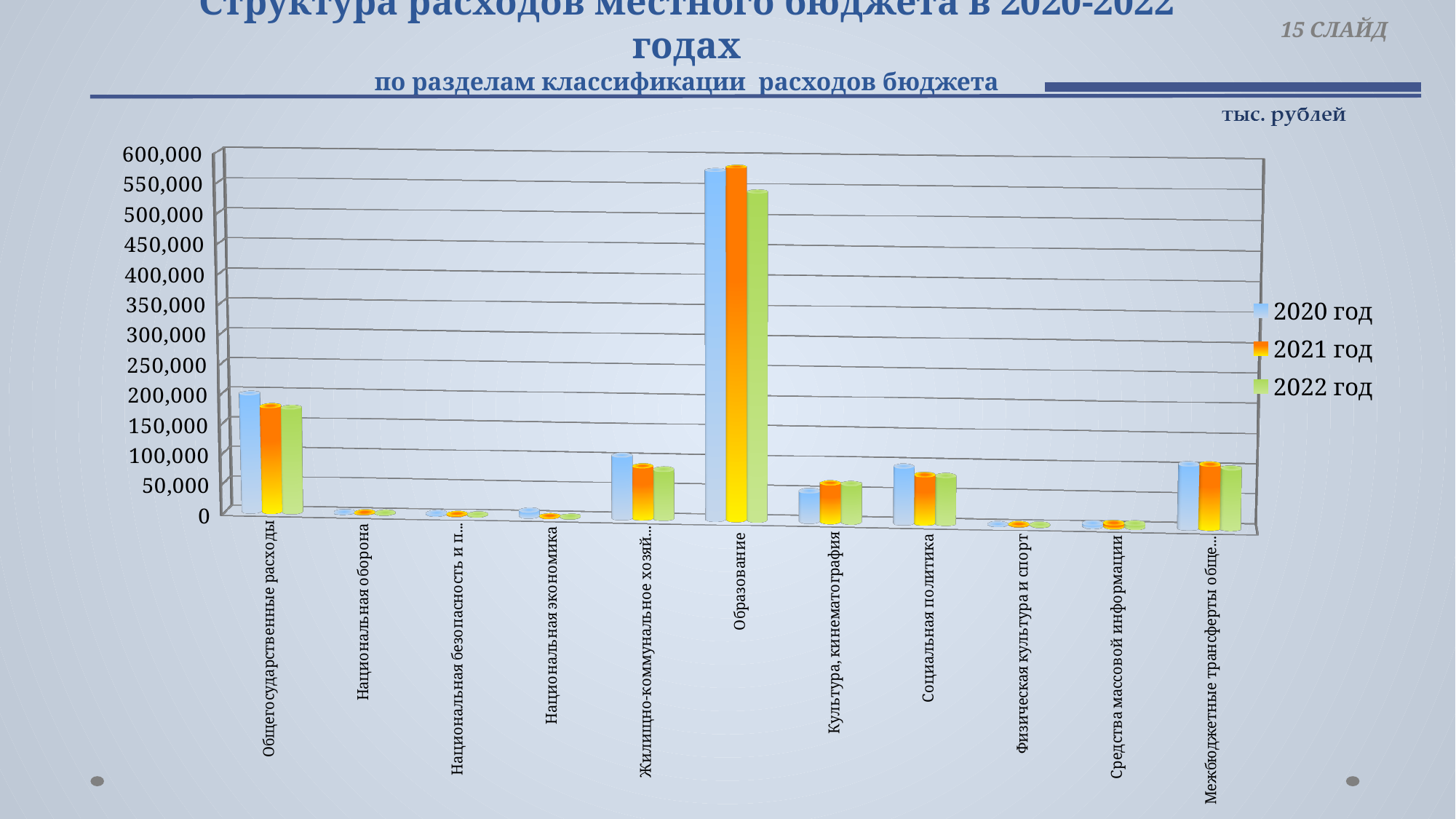
For Общегосударственные расходы, which is larger: the value for 2020 год or 2021 год? 2020 год Which category has the highest expenditure in the chart? Образование Is the value for Общегосударственные расходы in 2020 год greater or less than 150,000? greater What kind of chart is shown on the slide? bar chart Which years are listed in the chart legend? 2020 год, 2021 год, 2022 год Is the value for Образование in 2020 год greater or less than 500,000? greater How many expenditure categories are shown along the x axis? 11 For Образование, which is larger: the value for 2021 год or 2022 год? 2021 год In what units are the values on the chart expressed, according to the slide? тыс. рублей Which is larger: the value for Образование in 2022 год or the value for Общегосударственные расходы in 2022 год? Образование How many series does the legend list? 3